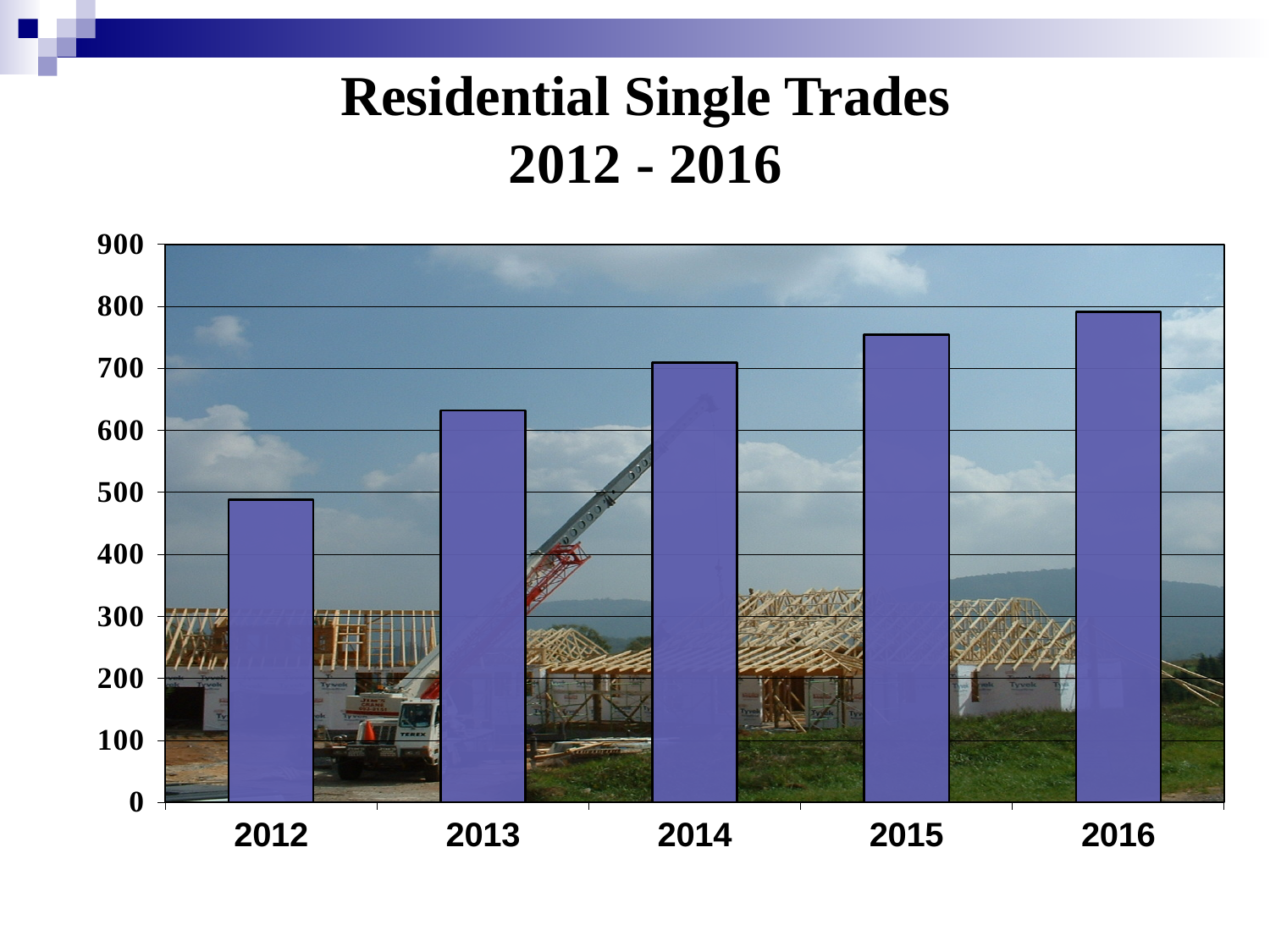
Which year has the lowest value in the chart? 2012 Is the value for 2012 greater or less than 400? greater Is the value for 2013 greater or less than 600? greater Is the value for 2015 greater or less than 700? greater Which year has the highest value in the chart? 2016 What is the maximum value shown on the y axis? 900 What is the title of the chart? Residential Single Trades 2012 - 2016 Which is larger, the value for 2013 or the value for 2015? 2015 What kind of chart is shown on the slide? bar chart Do the values rise or fall from 2012 to 2016? rise How many years are shown on the x axis of the chart? 5